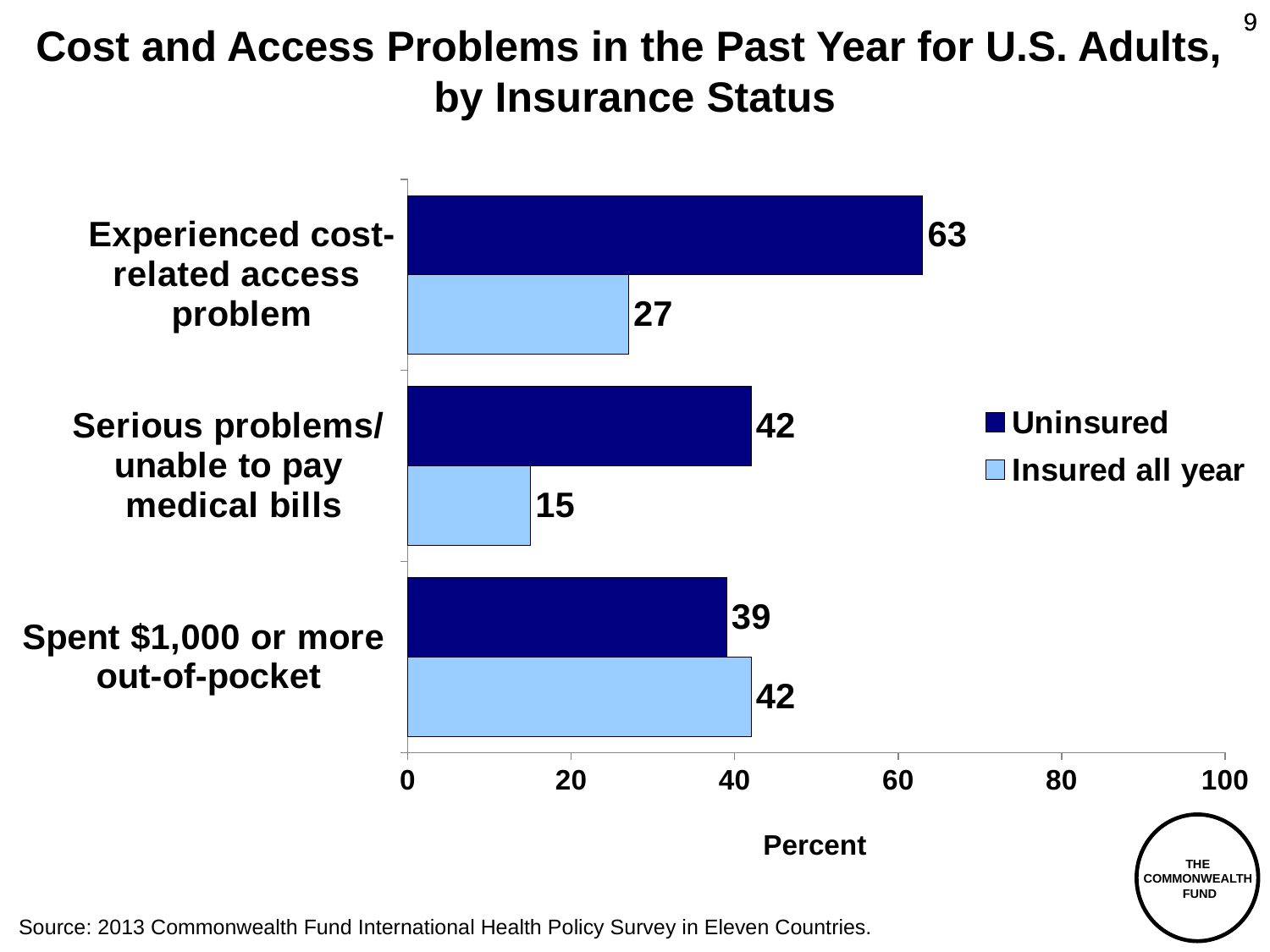
What percent of adults insured all year had serious problems or were unable to pay medical bills? 15 How many categories are shown on the chart? 3 Which category has the highest value for the Uninsured series? Experienced cost-related access problem What is the label of the horizontal axis? Percent Is the Uninsured value for serious problems/unable to pay medical bills greater or less than 40? greater For spending $1,000 or more out-of-pocket, which group has the larger value, Uninsured or Insured all year? Insured all year Which category has the lowest value for the Insured all year series? Serious problems/unable to pay medical bills How many series does the legend list? 2 What percent of uninsured adults experienced a cost-related access problem? 63 What is the difference between the Uninsured and Insured all year values for experiencing a cost-related access problem? 36 What kind of chart is shown on the slide? Bar chart What percent of adults insured all year spent $1,000 or more out-of-pocket? 42